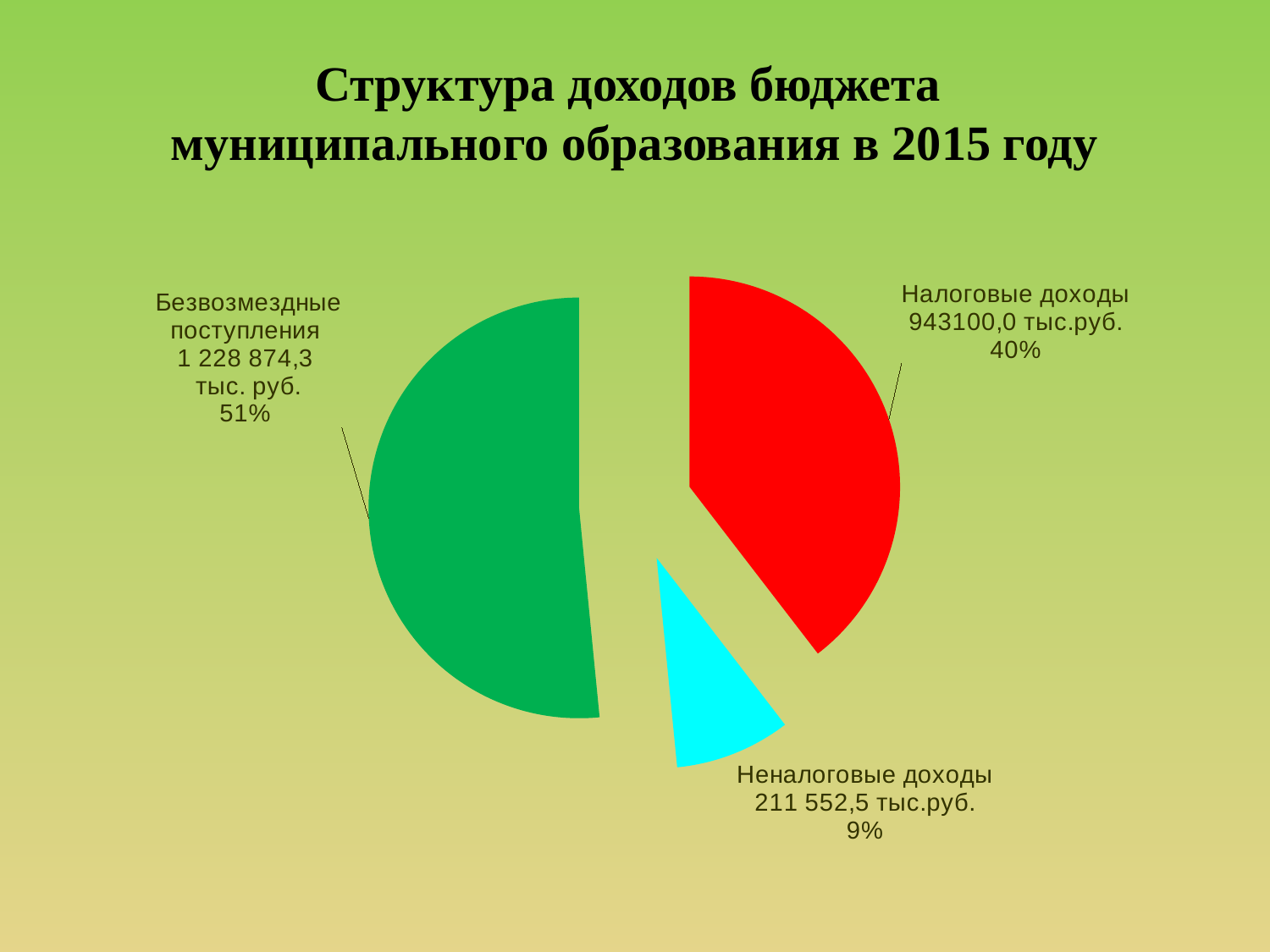
What is the title of the chart on the slide? Структура доходов бюджета муниципального образования в 2015 году What share of the pie is Налоговые доходы? 40% What type of chart is shown on the slide? pie chart What share of the pie is Неналоговые доходы? 9% What is the value shown for Налоговые доходы? 943100,0 тыс.руб. How many slices does the pie chart have? 3 By how many percentage points does the share of Безвозмездные поступления exceed the share of Налоговые доходы? 11 What share of the pie is Безвозмездные поступления? 51% What is the value shown for Неналоговые доходы? 211 552,5 тыс.руб. Which category has the largest share of the pie? Безвозмездные поступления What is the value shown for Безвозмездные поступления? 1 228 874,3 тыс. руб. Which category has the smallest share of the pie? Неналоговые доходы